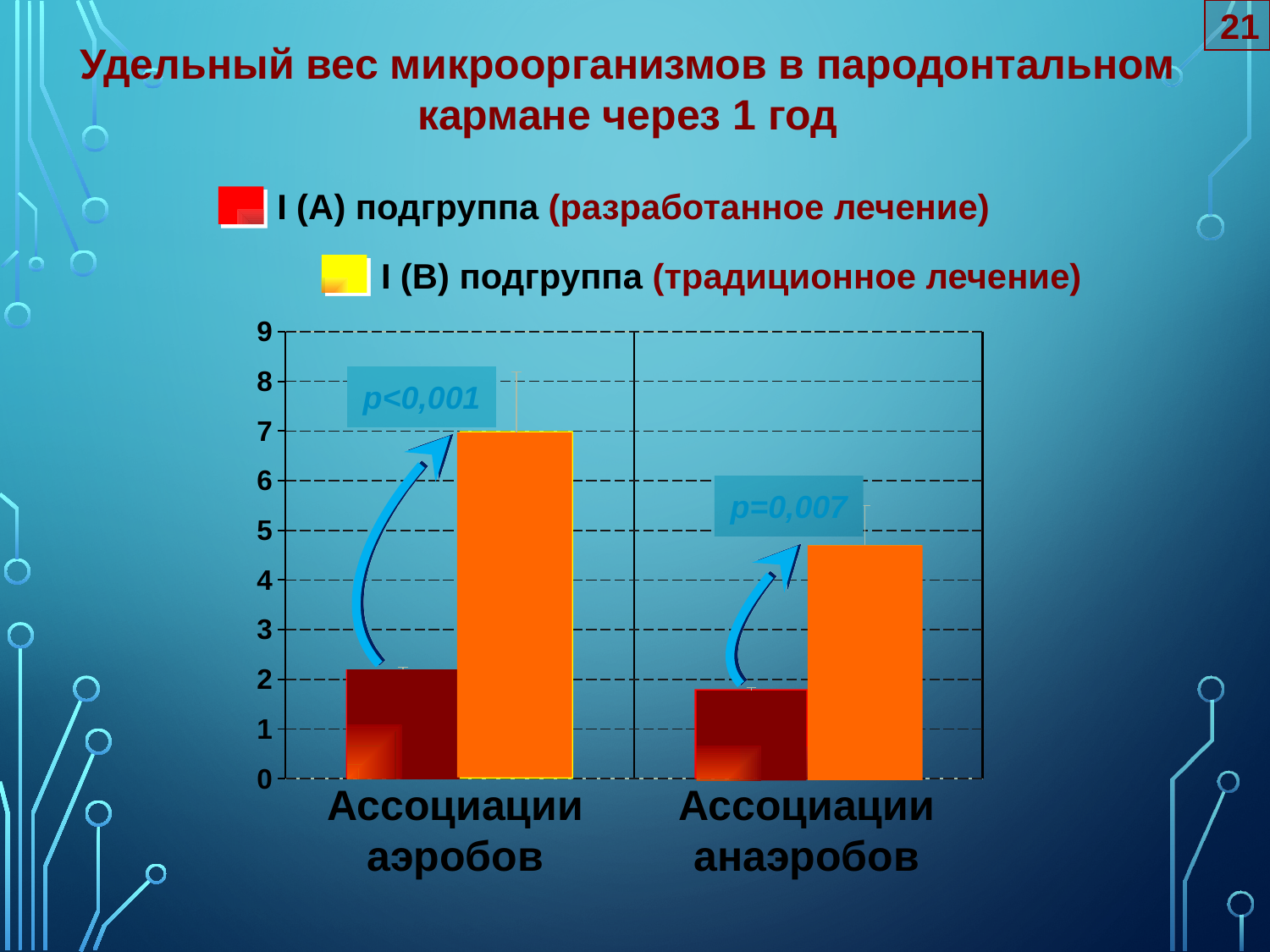
How many series does the legend list? 2 What kind of chart is shown on the slide? bar chart Is the value for I (А) подгруппа in the category Ассоциации анаэробов greater or less than 2? less Is the value for I (В) подгруппа in the category Ассоциации аэробов greater or less than 6? greater Is the value for I (В) подгруппа in the category Ассоциации анаэробов greater or less than 4? greater How many categories are shown on the x axis of the chart? 2 In the category Ассоциации аэробов, which series has the larger value: I (А) подгруппа or I (В) подгруппа? I (В) подгруппа Which series is shown in yellow/orange in the chart? I (В) подгруппа (традиционное лечение) For I (В) подгруппа, which category has the higher value? Ассоциации аэробов What p-value is annotated above the bars for Ассоциации анаэробов? p=0,007 Which series is shown in red in the chart? I (А) подгруппа (разработанное лечение)